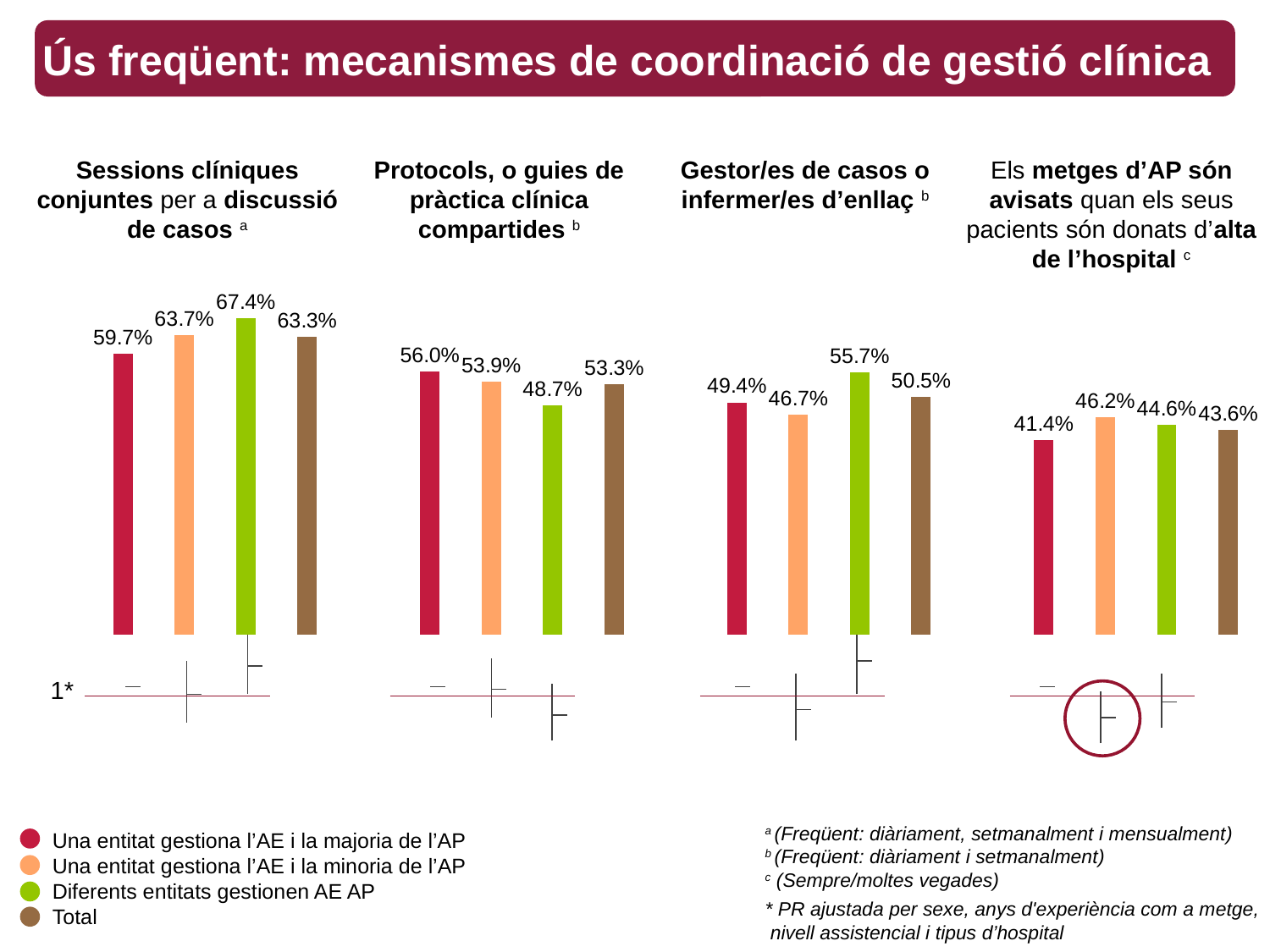
In the 'Sessions clíniques conjuntes per a discussió de casos' chart, which group has the highest value? Diferents entitats gestionen AE AP In the 'Sessions clíniques conjuntes per a discussió de casos' chart, what is the difference between the 'Diferents entitats gestionen AE AP' value and the 'Una entitat gestiona l'AE i la majoria de l'AP' value? 7.7% In the 'Gestor/es de casos o infermer/es d'enllaç' chart, what is the value for 'Diferents entitats gestionen AE AP'? 55.7% In the 'Protocols, o guies de pràctica clínica compartides' chart, which group has the lowest value? Diferents entitats gestionen AE AP In the chart about 'Els metges d'AP són avisats quan els seus pacients són donats d'alta de l'hospital', which group has the highest value? Una entitat gestiona l'AE i la minoria de l'AP In the 'Protocols, o guies de pràctica clínica compartides' chart, which is larger: the value for 'Una entitat gestiona l'AE i la minoria de l'AP' or the value for 'Total'? Una entitat gestiona l'AE i la minoria de l'AP In the chart about 'Els metges d'AP són avisats quan els seus pacients són donats d'alta de l'hospital', what is the value for 'Una entitat gestiona l'AE i la majoria de l'AP'? 41.4% In the 'Sessions clíniques conjuntes per a discussió de casos' chart, what is the value for 'Total'? 63.3% In the 'Gestor/es de casos o infermer/es d'enllaç' chart, what is the difference between the 'Diferents entitats gestionen AE AP' value and the 'Una entitat gestiona l'AE i la minoria de l'AP' value? 9.0% What kind of chart is used for 'Gestor/es de casos o infermer/es d'enllaç'? Bar chart How many series does the legend list? 4 In the 'Protocols, o guies de pràctica clínica compartides' chart, what is the value for 'Una entitat gestiona l'AE i la majoria de l'AP'? 56.0%